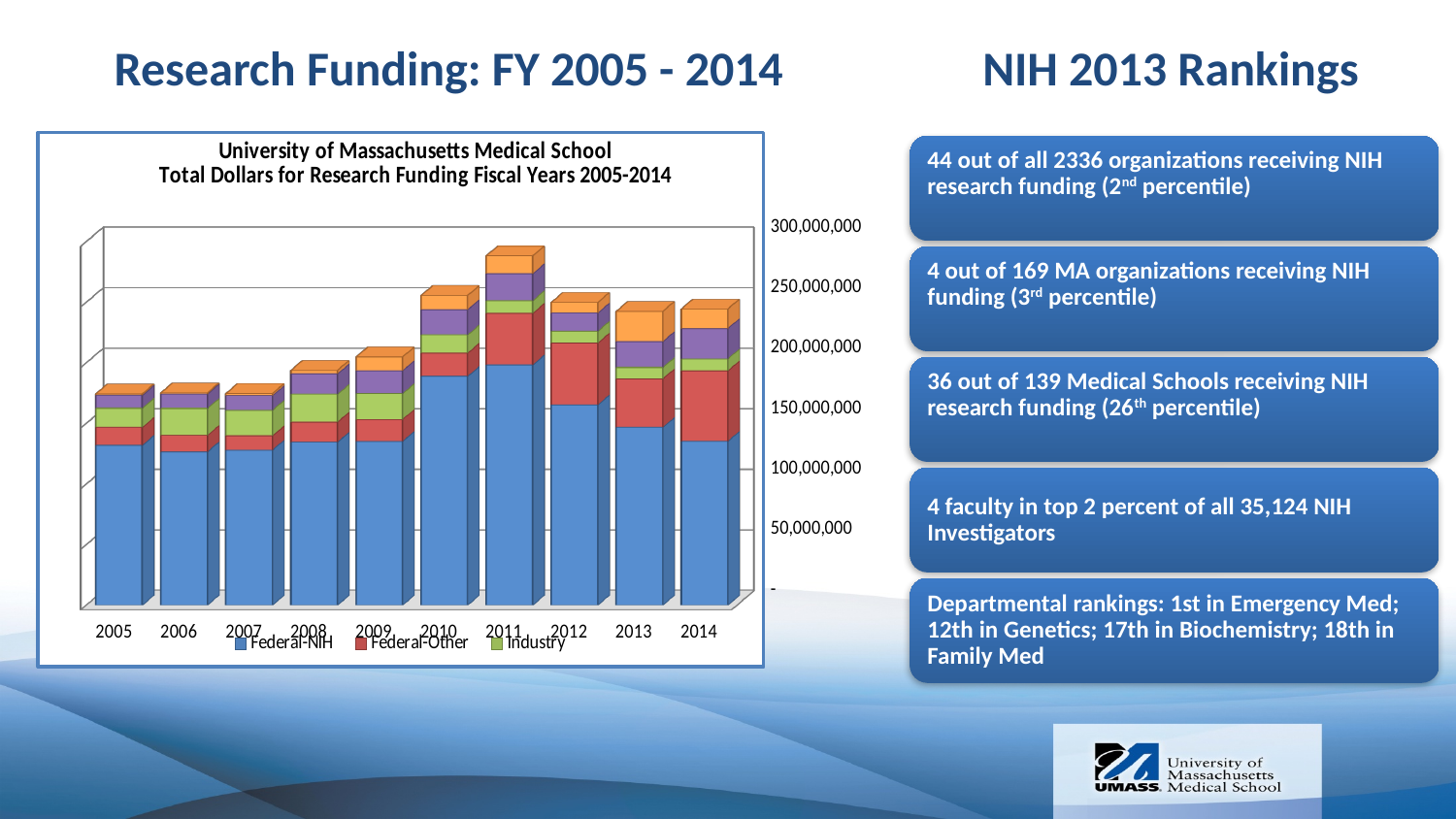
Which fiscal year has the highest total research funding in the chart? 2011 What is the title of the chart? University of Massachusetts Medical School Total Dollars for Research Funding Fiscal Years 2005-2014 How many fiscal years are plotted on the x axis of the chart? 10 What colour represents the Federal-NIH series in the chart? Blue What kind of chart is shown on the slide? Stacked bar chart Is the total research funding for 2011 greater or less than 250,000,000? greater Is the Federal-NIH funding for 2014 greater or less than 150,000,000? less Do the total research funding values generally rise or fall from 2005 to 2011? rise Is the total research funding for 2010 greater or less than 200,000,000? greater Which year has the larger total research funding, 2005 or 2011? 2011